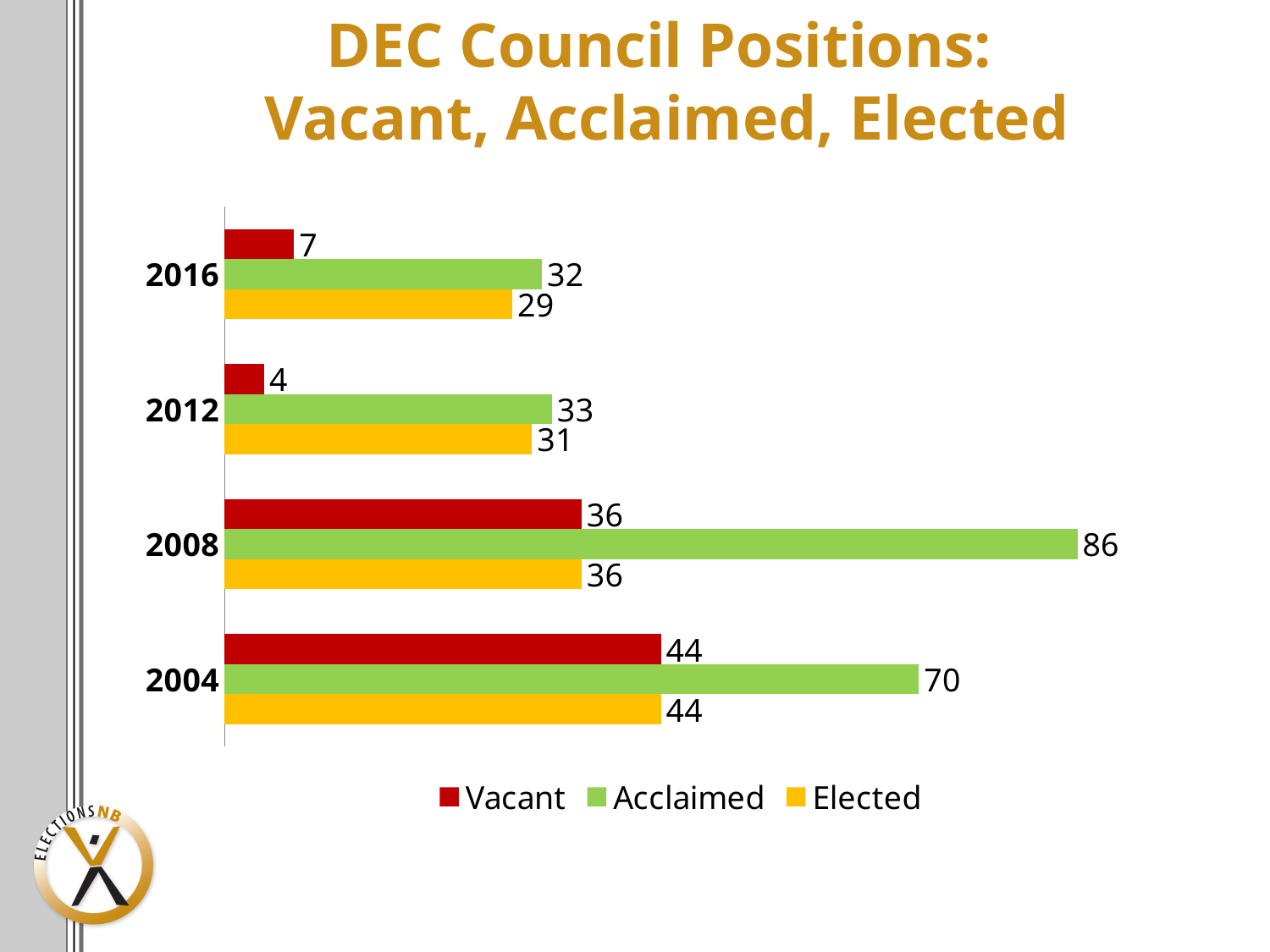
Which year has the lowest Vacant value? 2012 Which colour represents the Elected series? yellow Which year has the highest Acclaimed value? 2008 What is the difference between the Acclaimed and Elected values for 2004? 26 What is the Vacant value for 2016? 7 What is the total of Vacant, Acclaimed and Elected for 2016? 68 How many series does the legend list? 3 What kind of chart is shown? bar chart What is the Elected value for 2012? 31 How many years are shown on the chart? 4 Which is larger, the Vacant value for 2004 or the Vacant value for 2008? 2004 What is the Acclaimed value for 2008? 86